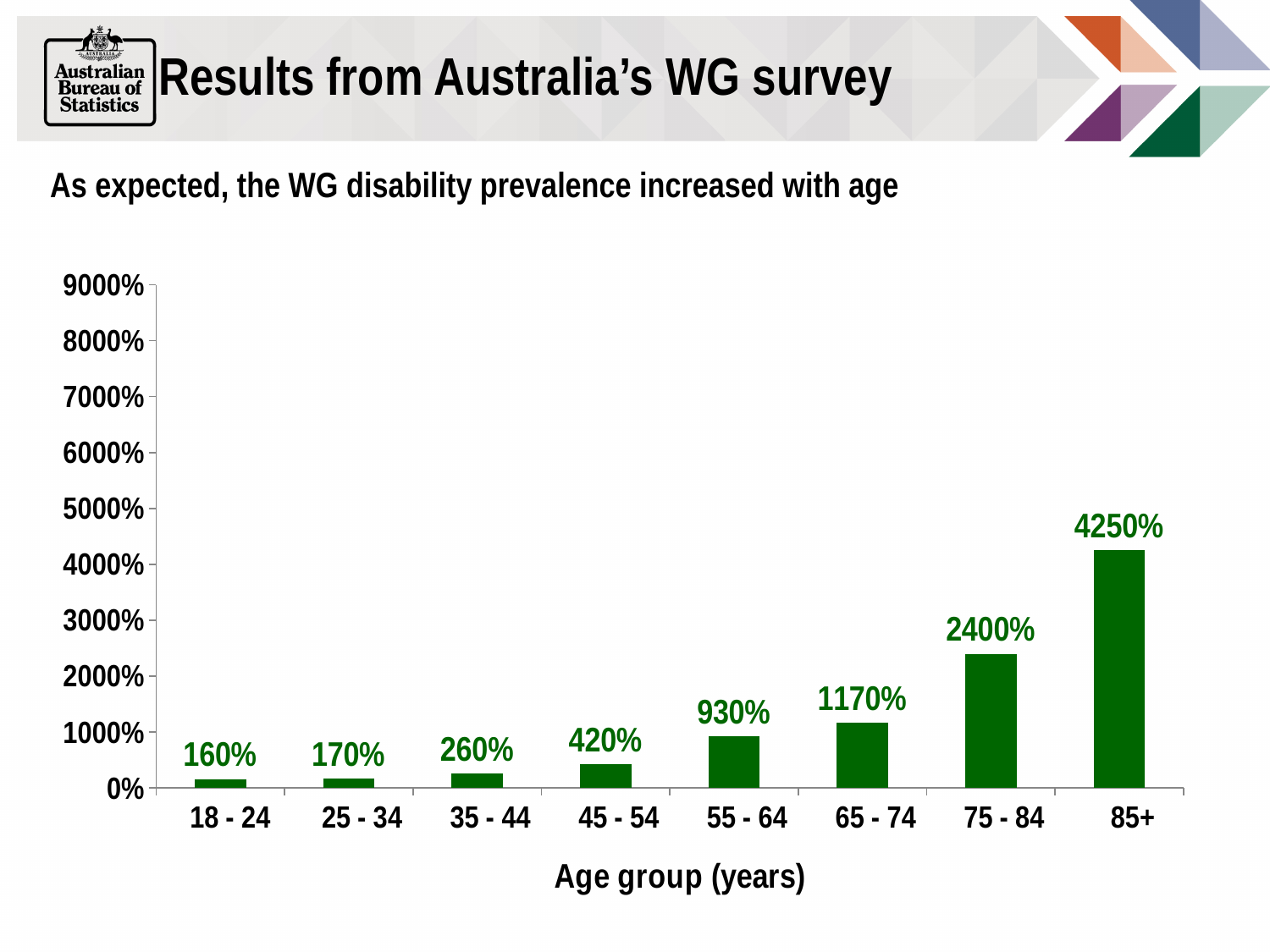
What kind of chart is shown on the slide? bar chart Which age group has the lowest value? 18 - 24 What is the difference between the values for 65 - 74 and 55 - 64? 240% What is the value for the 55 - 64 age group? 930% Which is larger, the value for 45 - 54 or the value for 35 - 44? 45 - 54 What is the value for the 85+ age group? 4250% Which age group has the highest value? 85+ What is the difference between the values for 85+ and 75 - 84? 1850% What is the value for the 18 - 24 age group? 160% Do the values rise or fall as age group increases along the x axis? rise How many age groups are shown on the x axis? 8 Is the value for 75 - 84 greater or less than 2000%? greater